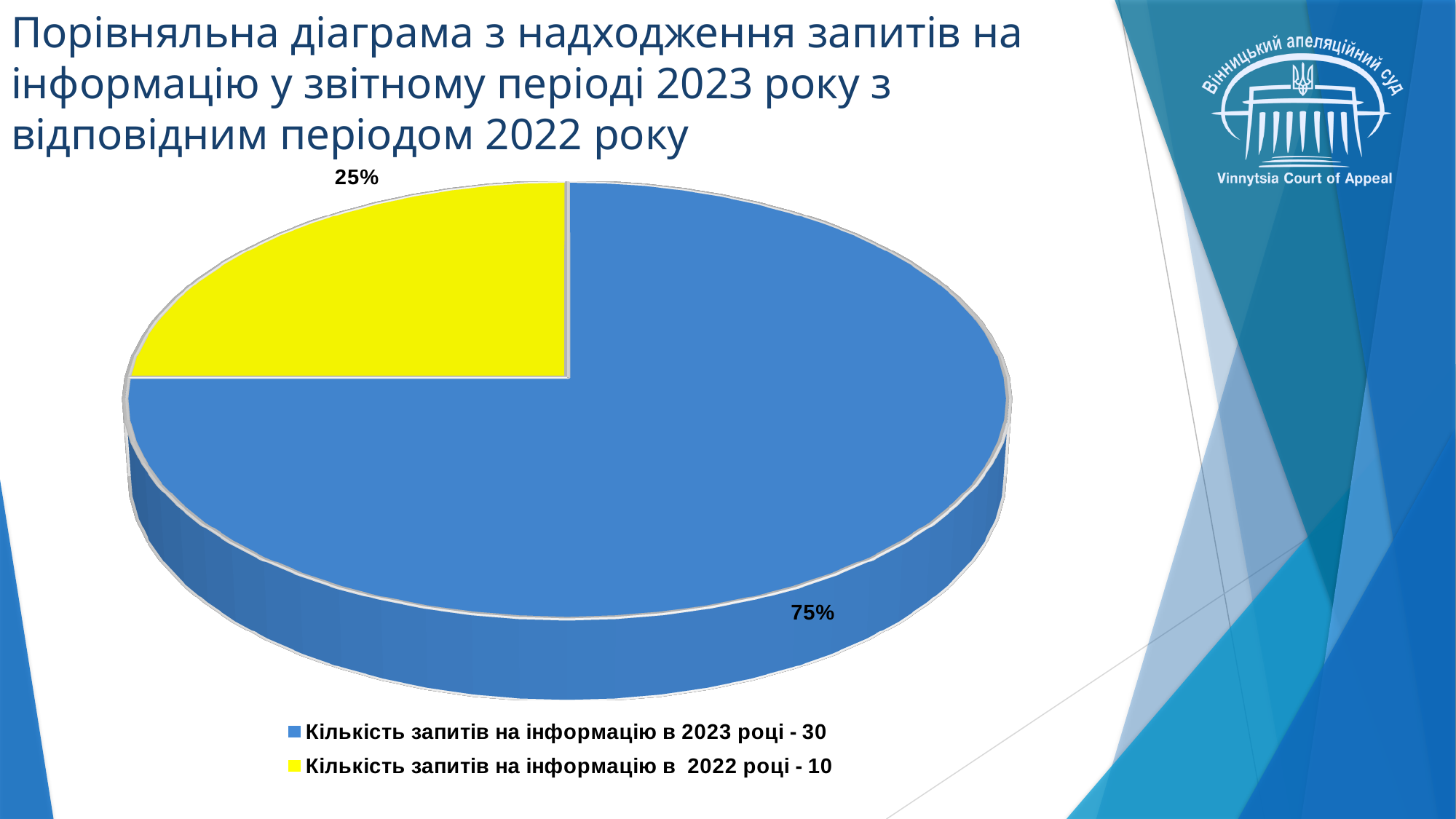
What share of the pie is labelled for the 2022 slice (Кількість запитів на інформацію в 2022 році)? 25% According to the legend, how many information requests were received in 2022? 10 How many entries does the legend list? 2 How many slices does the pie chart have? 2 According to the legend, how many information requests were received in 2023? 30 What share of the pie is labelled for the 2023 slice (Кількість запитів на інформацію в 2023 році)? 75% What is the difference in percentage points between the 2023 slice and the 2022 slice? 50% What kind of chart is shown on the slide? Pie chart Which year has the larger slice of the pie, 2023 or 2022? 2023 Which slice is the smallest in the pie chart? Кількість запитів на інформацію в 2022 році - 10 What is the difference between the number of requests in 2023 and in 2022, as given in the legend? 20 What colour is the slice representing 2022 requests? Yellow